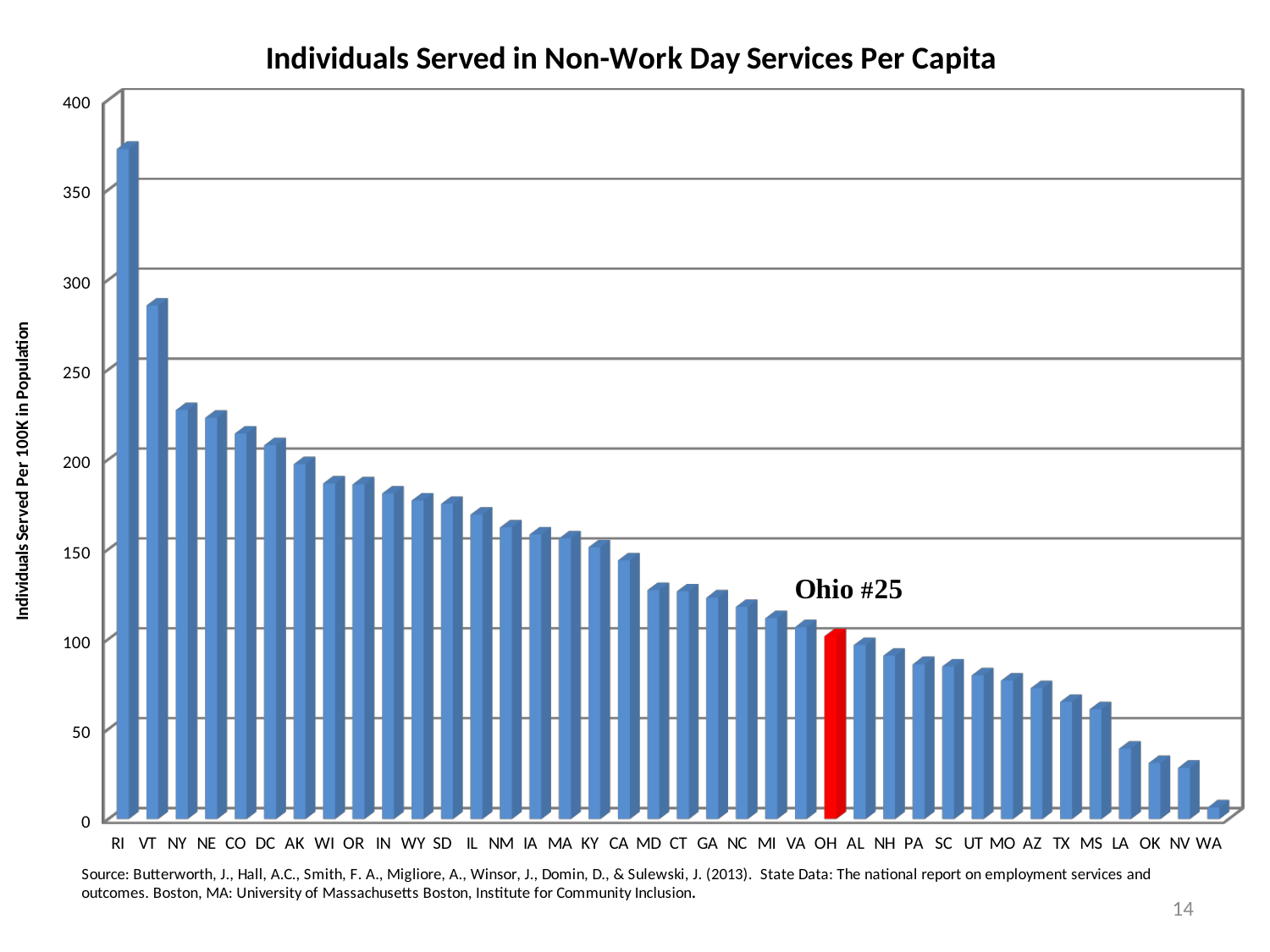
Which has a larger value, RI or VT? RI Is the value for MD greater or less than 150? less Is the value for LA greater or less than 50? less Is the value for RI greater or less than 350? greater Which state's bar is highlighted in red, and what rank is it labelled with? OH, Ohio #25 Which state has the lowest value for individuals served in non-work day services per capita? WA Do the values rise or fall moving from left to right along the x axis? fall Which state has the highest value for individuals served in non-work day services per capita? RI How many states (bars) are shown on the chart? 38 What kind of chart is shown on the slide? bar chart